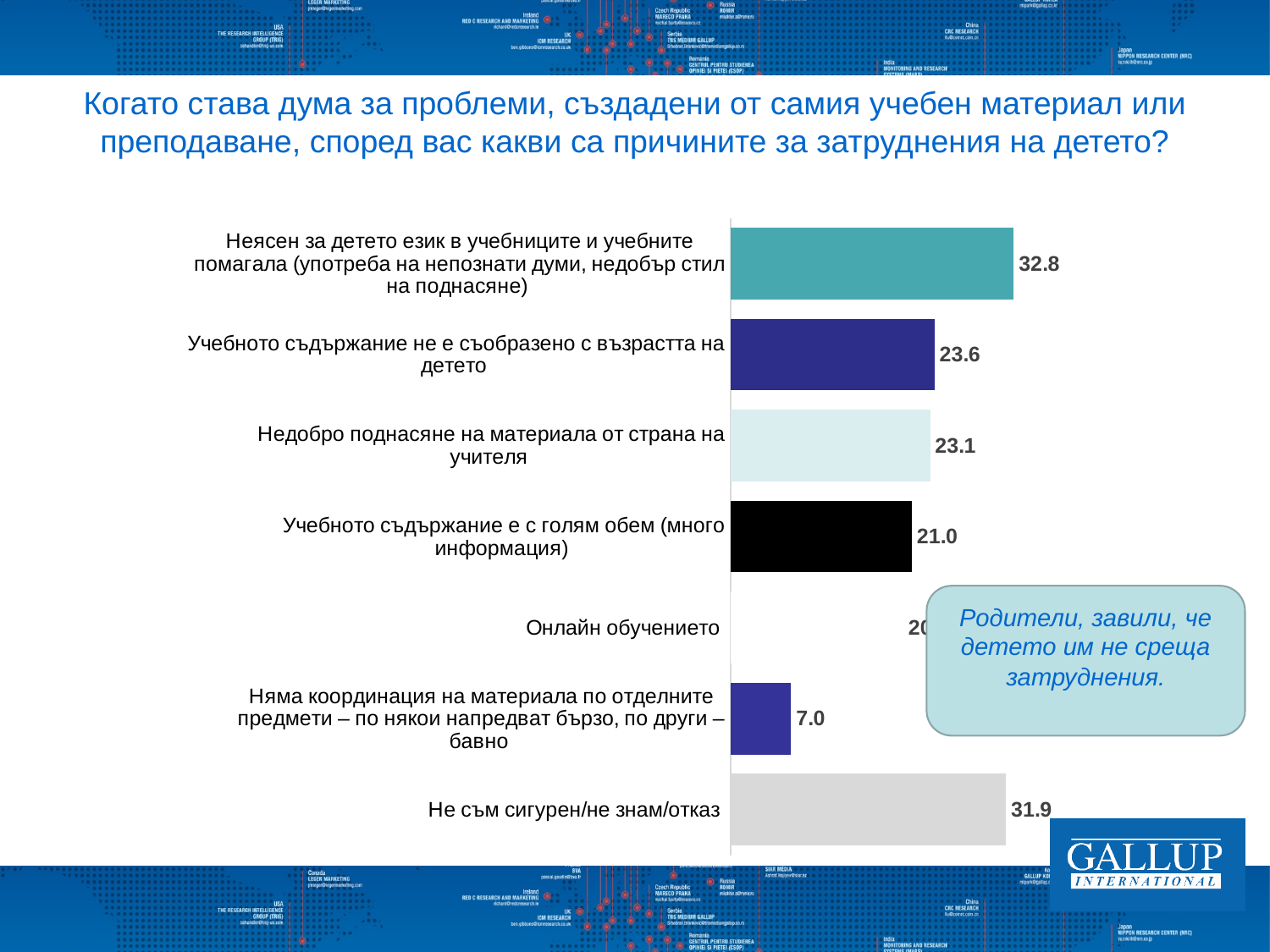
What is the value for "Няма координация на материала по отделните предмети – по някои напредват бързо, по други – бавно"? 7.0 Which category has the highest value? Неясен за детето език в учебниците и учебните помагала (употреба на непознати думи, недобър стил на поднасяне) What is the difference between the value for "Неясен за детето език в учебниците и учебните помагала" and the value for "Няма координация на материала по отделните предмети"? 25.8 How many categories are shown in the chart? 7 What is the value for "Не съм сигурен/не знам/отказ"? 31.9 What is the value for "Неясен за детето език в учебниците и учебните помагала (употреба на непознати думи, недобър стил на поднасяне)"? 32.8 Which category has the lowest value? Няма координация на материала по отделните предмети – по някои напредват бързо, по други – бавно What kind of chart is shown on the slide? Bar chart What is the value for "Учебното съдържание е с голям обем (много информация)"? 21.0 What is the value for "Учебното съдържание не е съобразено с възрастта на детето"? 23.6 What is the value for "Недобро поднасяне на материала от страна на учителя"? 23.1 Which is larger: the value for "Не съм сигурен/не знам/отказ" or the value for "Учебното съдържание е с голям обем (много информация)"? Не съм сигурен/не знам/отказ